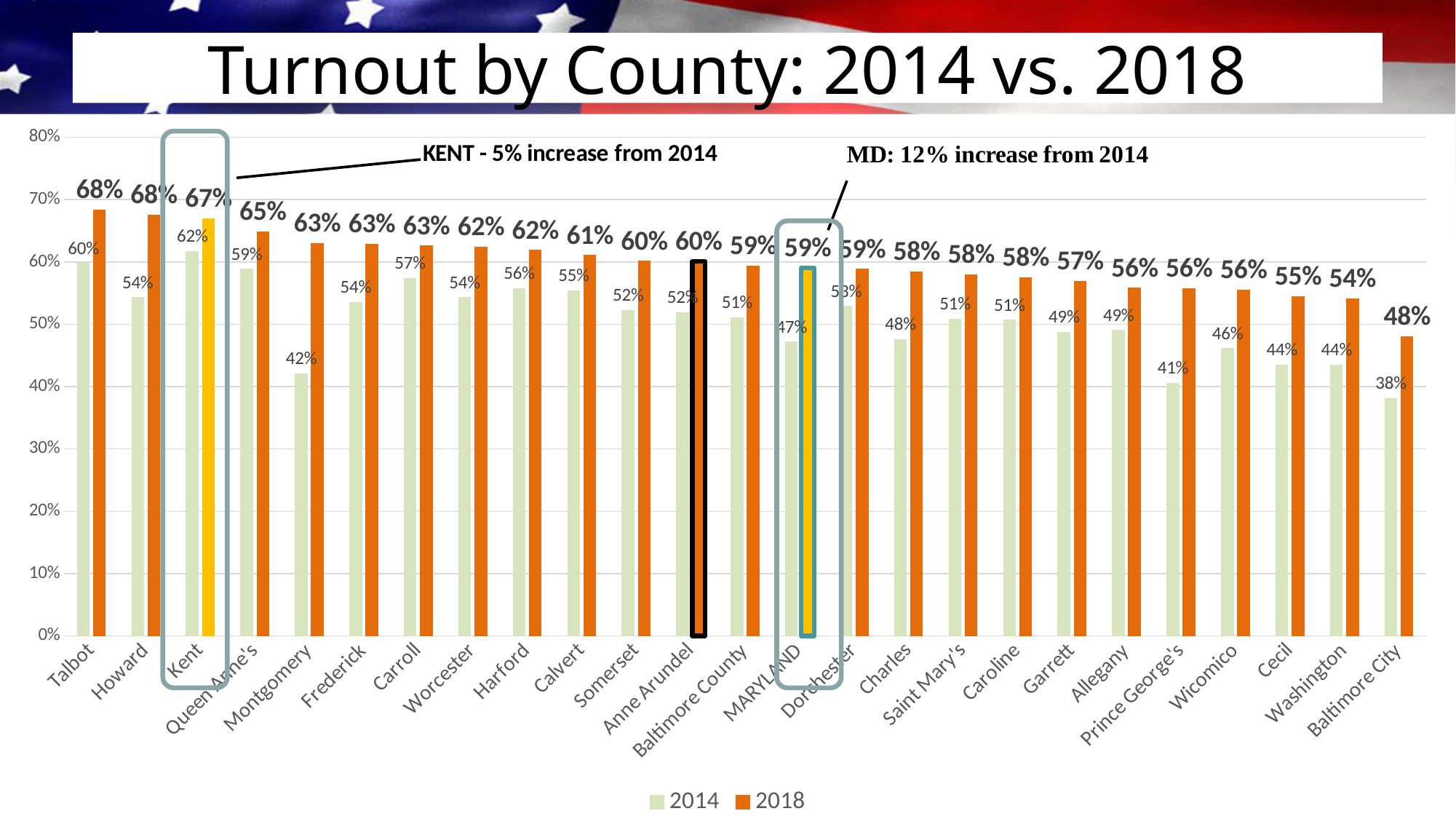
What was the 2014 turnout for Prince George's? 41% Which county had the highest 2014 turnout? Kent What was the 2014 turnout for MARYLAND? 47% What was the 2018 turnout for Montgomery? 63% How many series does the legend list? 2 Which had the higher 2014 turnout, Talbot or Howard? Talbot What was the 2018 turnout for Baltimore City? 48% What is the difference between Kent's 2018 and 2014 turnout? 5% Which category had the lowest 2018 turnout? Baltimore City Do the 2018 turnout values generally rise or fall from left to right along the x axis? fall How many categories are shown on the x axis? 25 What is the difference between Montgomery's 2018 and 2014 turnout? 21%